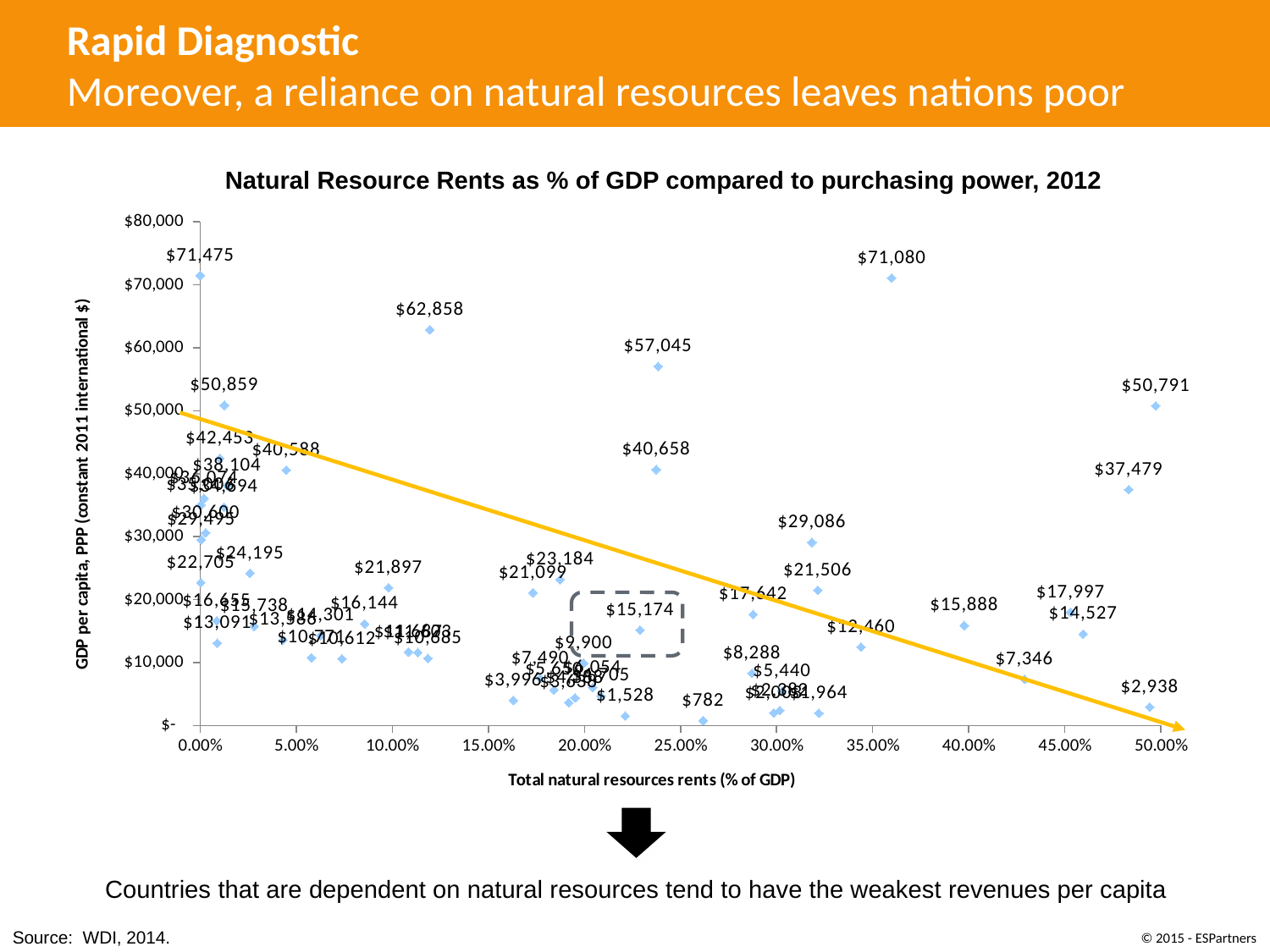
Is the value of the point at about 24% natural resource rents labelled $57,045 greater or less than $50,000? greater What is the title of the chart? Natural Resource Rents as % of GDP compared to purchasing power, 2012 What is the value of the rightmost point on the chart, at about 50% natural resource rents? $50,791 According to the trend line, do GDP per capita values rise or fall as natural resource rents increase? Fall Which is larger, the point labelled $62,858 or the point labelled $57,045? $62,858 What is the label of the horizontal axis of the chart? Total natural resources rents (% of GDP) What is the lowest GDP per capita value labelled on the chart? $782 What is the highest GDP per capita value labelled on the chart? $71,475 Is the value of the point at about 36% natural resource rents greater or less than $60,000? greater What is the difference between the two highest labelled values, $71,475 and $71,080? $395 What kind of chart is shown on the slide? Scatter chart What is the value of the point enclosed by the dashed box? $15,174